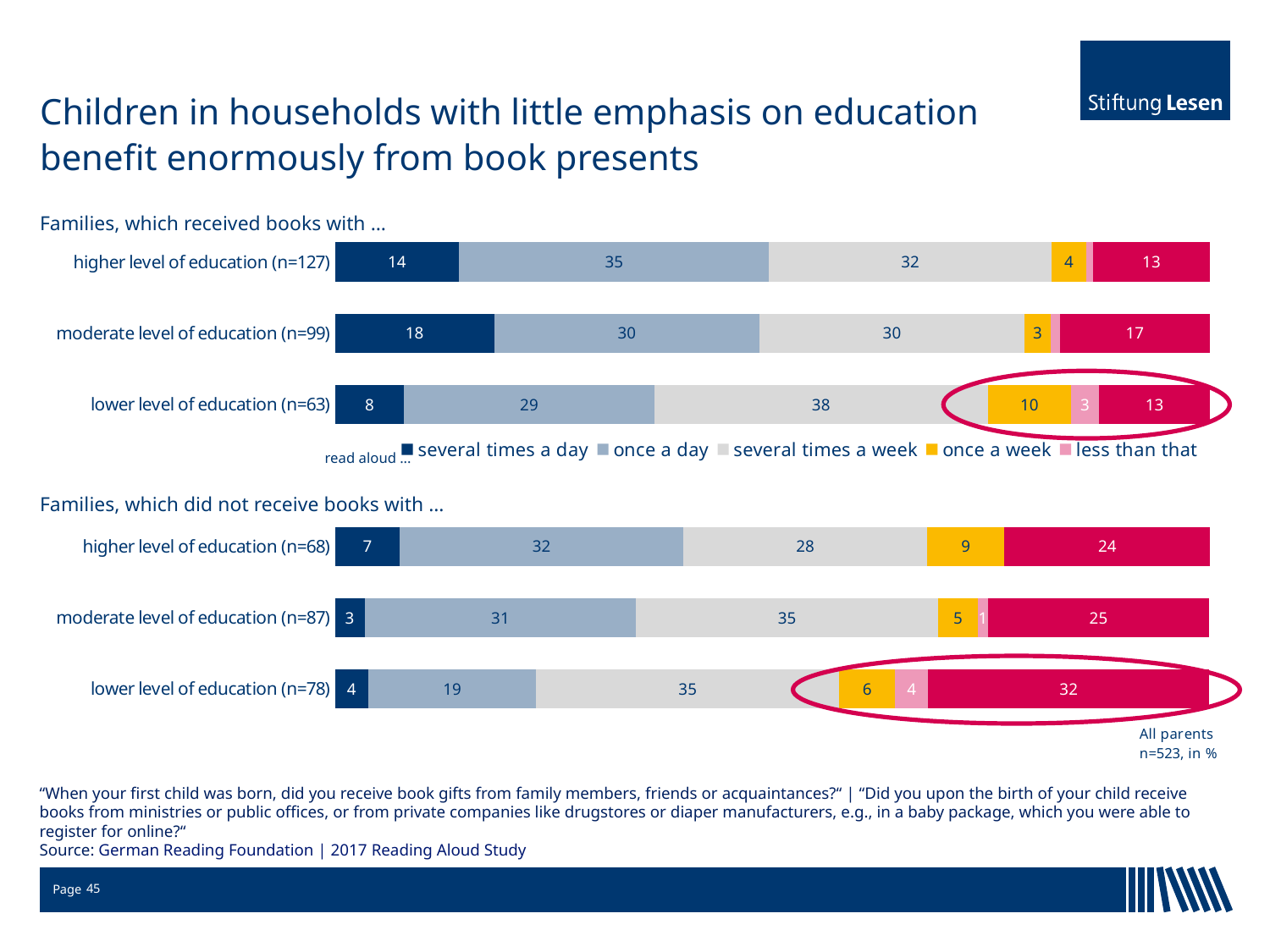
In the chart 'Families, which received books with ...', which education level has the highest value for 'several times a day'? moderate level of education (n=99) In the chart 'Families, which did not receive books with ...', what is the value for 'less than that' for the lower level of education (n=78)? 4 In the chart 'Families, which did not receive books with ...', which education level has the lowest value for 'once a day'? lower level of education (n=78) In the chart 'Families, which received books with ...', what is the value for 'once a week' for the lower level of education (n=63)? 10 How many education-level categories are shown in the chart 'Families, which did not receive books with ...'? 3 In the chart 'Families, which received books with ...', which is larger: the 'once a day' value for the higher level of education (n=127) or for the lower level of education (n=63)? higher level of education (n=127) How many series does the legend list? 5 In the chart 'Families, which did not receive books with ...', what is the value for 'once a day' for the higher level of education (n=68)? 32 What kind of chart is used on this slide? stacked bar chart In the chart 'Families, which did not receive books with ...', what is the total of the labelled segments for the moderate level of education (n=87)? 100 In the chart 'Families, which received books with ...', what is the value for 'several times a week' for the lower level of education (n=63)? 38